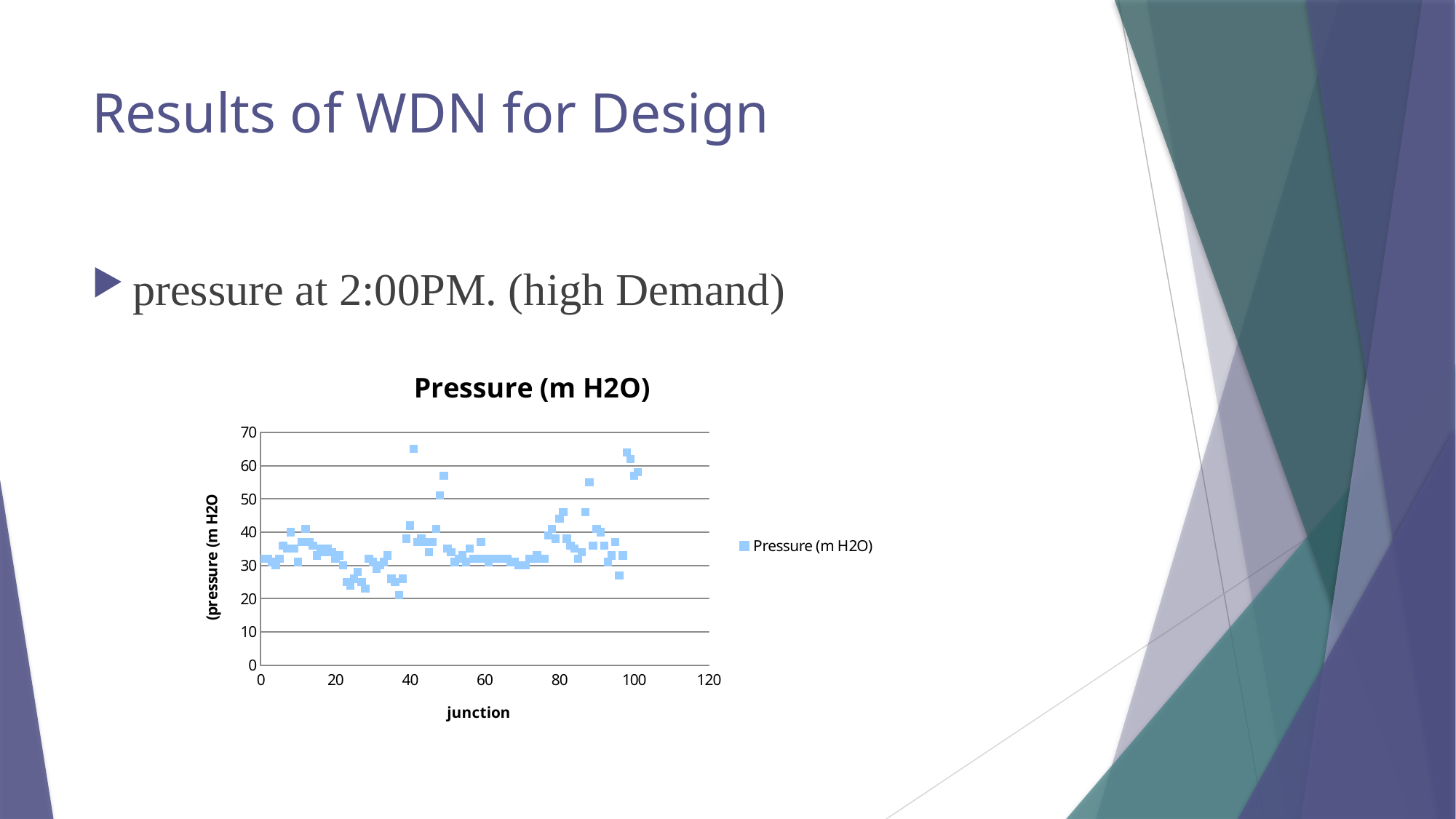
What is the label of the x axis of the chart? junction Is the lowest plotted pressure value greater or less than 10? greater Is the lowest plotted pressure value greater or less than 30? less How many series does the legend of the chart list? 1 Is the highest plotted pressure value greater or less than 70? less What is the title of the chart? Pressure (m H2O) What kind of chart is shown on the slide? scatter chart